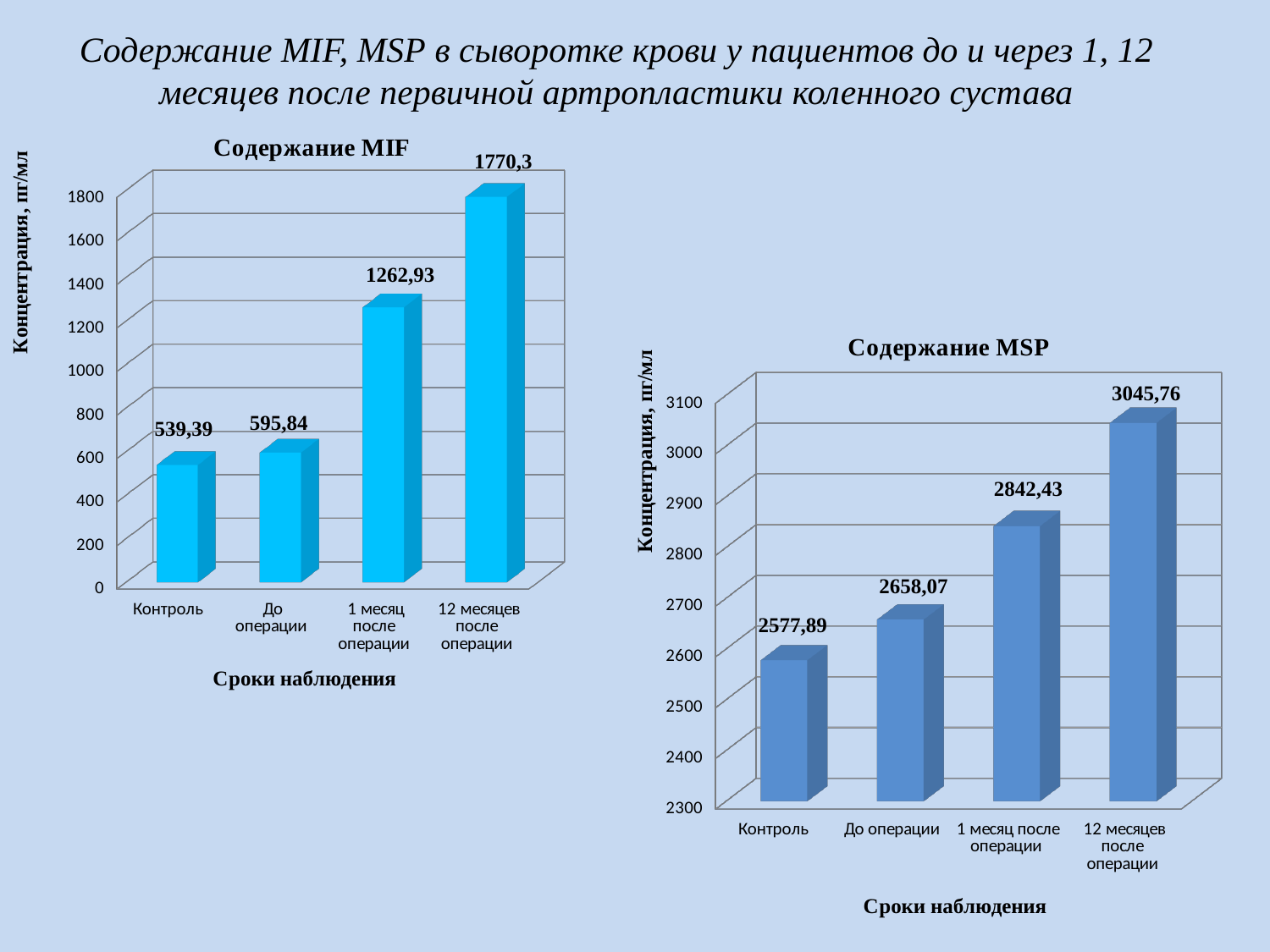
How many categories are shown in the chart titled "Содержание MSP"? 4 In the chart titled "Содержание MIF", what is the value for "12 месяцев после операции"? 1770,3 In the chart titled "Содержание MSP", which category has the lowest value? Контроль In the chart titled "Содержание MIF", what is the difference between the values for "12 месяцев после операции" and "Контроль"? 1230,91 What kind of chart is the chart titled "Содержание MIF"? Bar chart In the chart titled "Содержание MSP", what is the difference between the values for "1 месяц после операции" and "До операции"? 184,36 In the chart titled "Содержание MIF", which category has the highest value? 12 месяцев после операции In the chart titled "Содержание MIF", what is the value for "Контроль"? 539,39 In the chart titled "Содержание MSP", do the values rise or fall from left to right along the x axis? Rise In the chart titled "Содержание MSP", what is the value for "До операции"? 2658,07 In the chart titled "Содержание MSP", what is the value for "1 месяц после операции"? 2842,43 In the chart titled "Содержание MIF", which is larger: the value for "До операции" or the value for "1 месяц после операции"? 1 месяц после операции